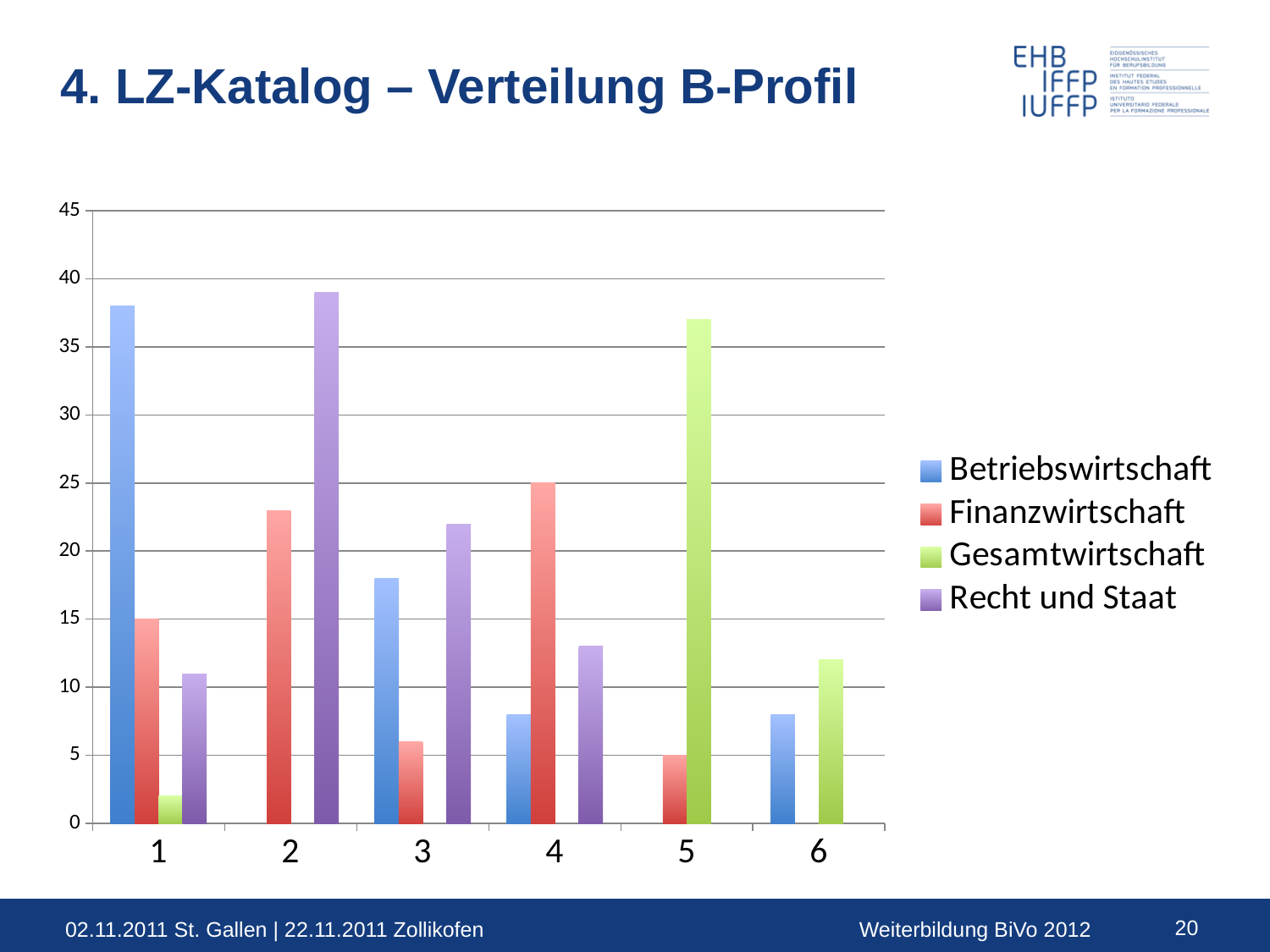
What is the value for Finanzwirtschaft in category 5? 5 What is the value for Finanzwirtschaft in category 1? 15 What is the value for Finanzwirtschaft in category 4? 25 In which category is the Betriebswirtschaft bar highest? 1 In which category is the Gesamtwirtschaft bar highest? 5 Which is larger in category 3: Betriebswirtschaft or Finanzwirtschaft? Betriebswirtschaft What kind of chart is shown on the slide? bar chart Is the value for Recht und Staat in category 2 greater or less than 35? greater How many series does the legend list? 4 How many categories are shown on the x axis? 6 Is the value for Gesamtwirtschaft in category 6 greater or less than 10? greater Is the value for Betriebswirtschaft in category 1 greater or less than 35? greater